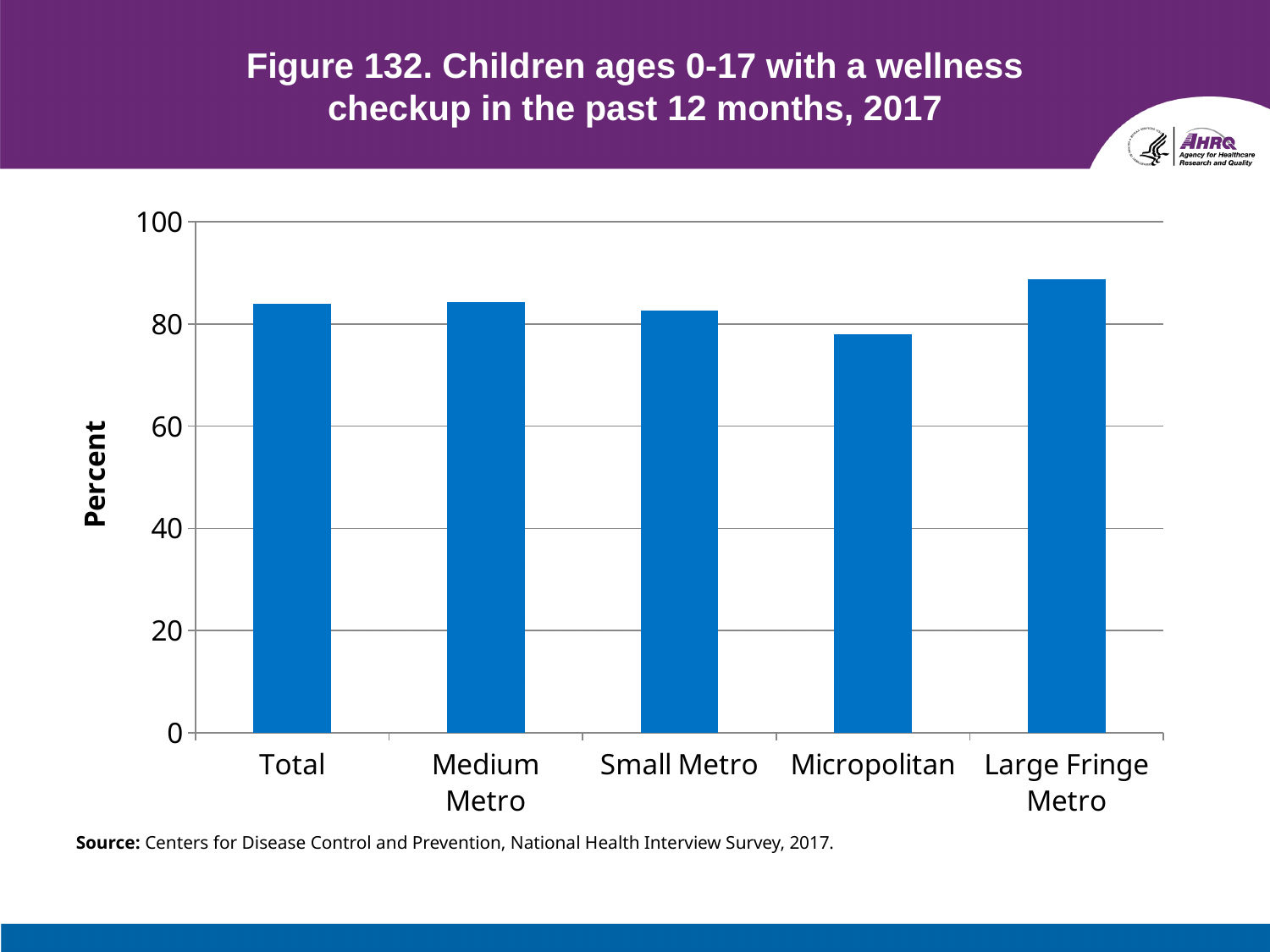
Is the value for Total greater or less than 80? greater What kind of chart is shown on the slide? Bar chart What is the title of the chart on the slide? Figure 132. Children ages 0-17 with a wellness checkup in the past 12 months, 2017 Is the value for Large Fringe Metro greater or less than 80? greater What is the label on the vertical axis of the chart? Percent Which category has the highest value in the chart? Large Fringe Metro Is the value for Medium Metro greater or less than 60? greater Which category has the lowest value in the chart? Micropolitan Which is larger, the value for Large Fringe Metro or the value for Micropolitan? Large Fringe Metro Which is larger, the value for Small Metro or the value for Micropolitan? Small Metro How many categories are shown on the x axis of the chart? 5